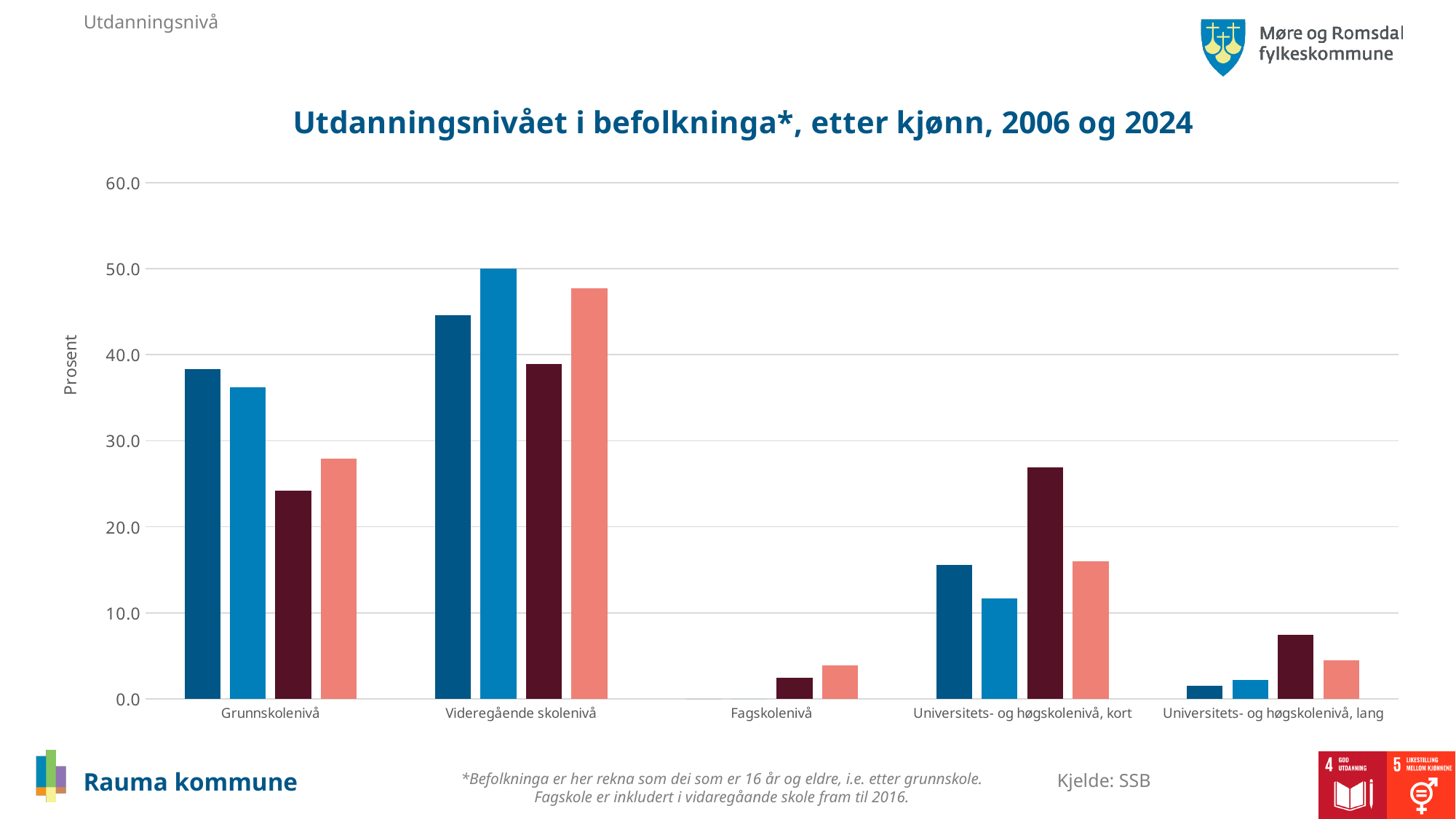
Which is larger: the first (dark blue) bar for Grunnskolenivå or the first (dark blue) bar for Videregående skolenivå? Videregående skolenivå Is the first (dark blue) bar for Grunnskolenivå greater or less than 30? greater What is the title of the chart? Utdanningsnivået i befolkninga*, etter kjønn, 2006 og 2024 How many education-level categories are shown on the x axis? 5 Which category has the tallest bars overall? Videregående skolenivå Is the last (salmon) bar for Universitets- og høgskolenivå, lang greater or less than 10? less What is the label on the y axis? Prosent Is the third (dark red) bar for Fagskolenivå greater or less than 10? less Which category has the lowest values overall? Fagskolenivå What kind of chart is shown on the slide? bar chart